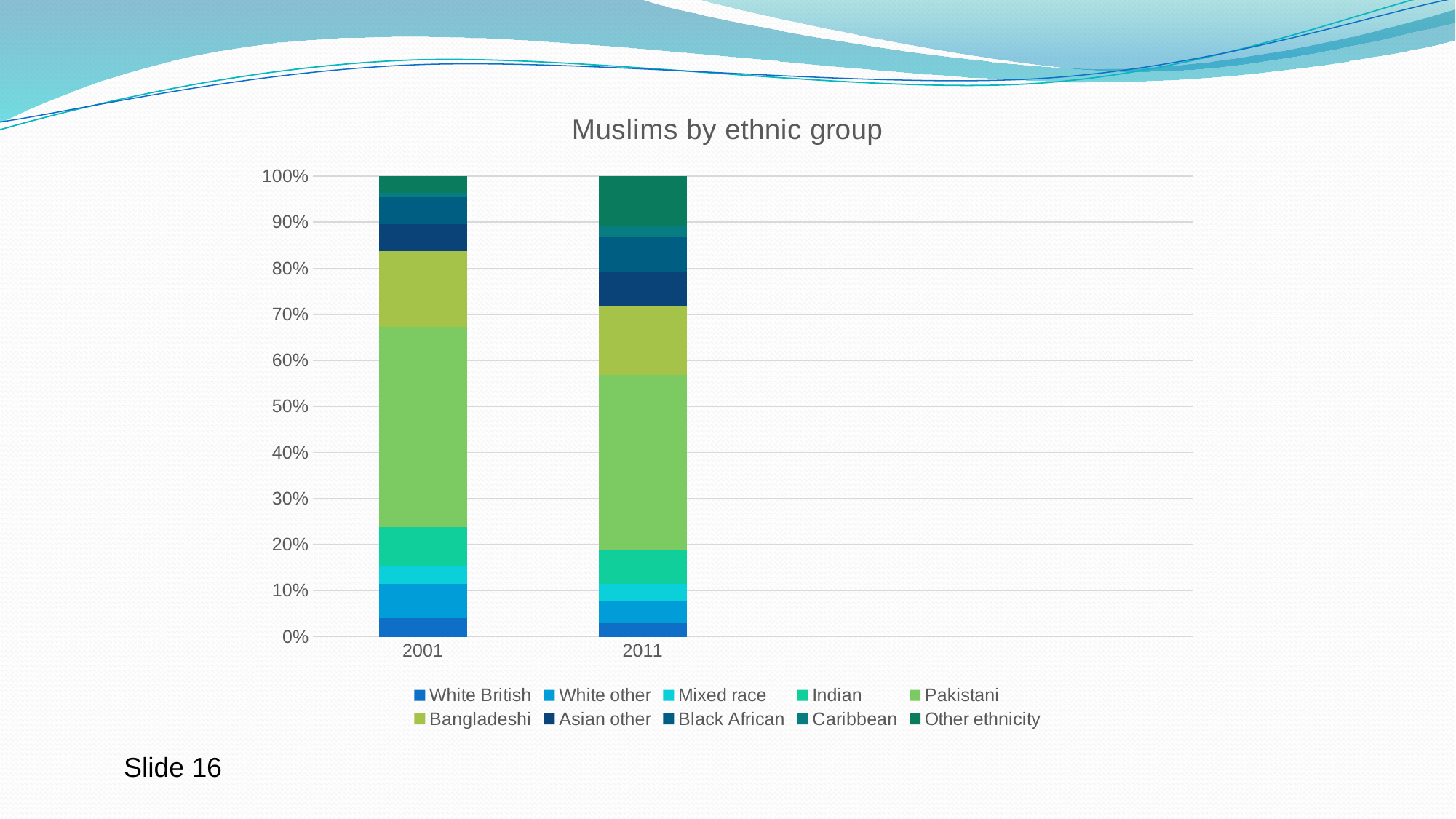
Is the Other ethnicity share larger in 2001 or in 2011? 2011 What does each stacked bar total on the y axis? 100% How many years (categories) are shown on the x axis of the chart? 2 Is the White British share in 2011 greater or less than 10%? less Is the White other share larger in 2001 or in 2011? 2001 Is the Pakistani share in 2001 greater or less than 30%? greater Which ethnic group makes up the largest share of the 2011 bar? Pakistani Is the Other ethnicity share in 2011 greater or less than 5%? greater What kind of chart is shown on the slide? Stacked bar chart Which ethnic group makes up the largest share of the 2001 bar? Pakistani How many ethnic groups (series) does the legend list? 10 What is the title of the chart? Muslims by ethnic group